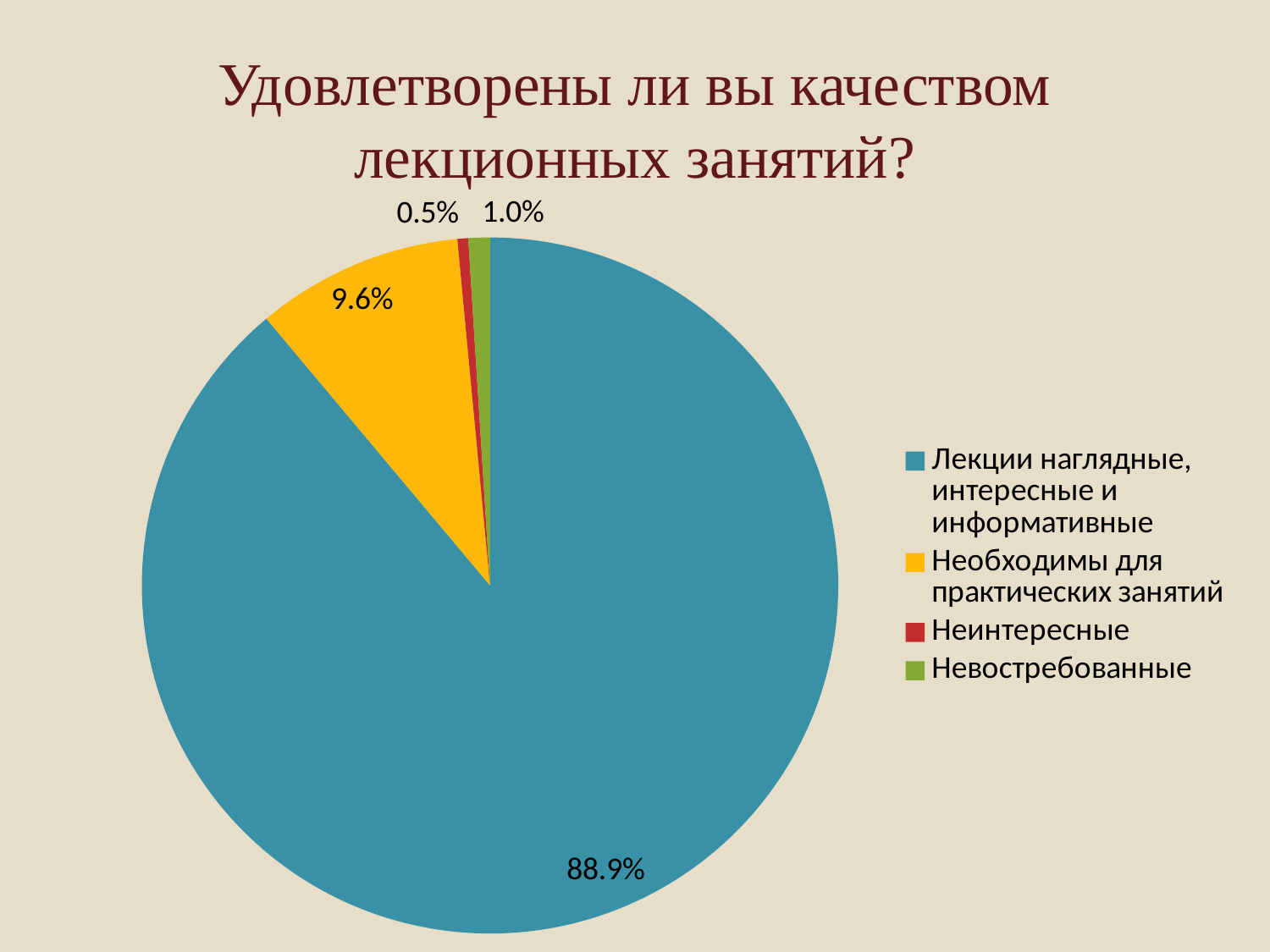
How many categories does the pie chart have? 4 What share of the pie is labelled 'Неинтересные'? 0.5% Which category has the largest slice of the pie? Лекции наглядные, интересные и информативные What share of the pie is labelled 'Невостребованные'? 1.0% Which is larger: the share for 'Невостребованные' or the share for 'Неинтересные'? Невостребованные What share of the pie is labelled 'Необходимы для практических занятий'? 9.6% What colour is the slice for 'Необходимы для практических занятий'? yellow What kind of chart is shown on the slide? pie chart What is the difference between the shares for 'Лекции наглядные, интересные и информативные' and 'Необходимы для практических занятий'? 79.3% What is the title of the chart on the slide? Удовлетворены ли вы качеством лекционных занятий? Which category has the smallest slice of the pie? Неинтересные What share of the pie is labelled 'Лекции наглядные, интересные и информативные'? 88.9%